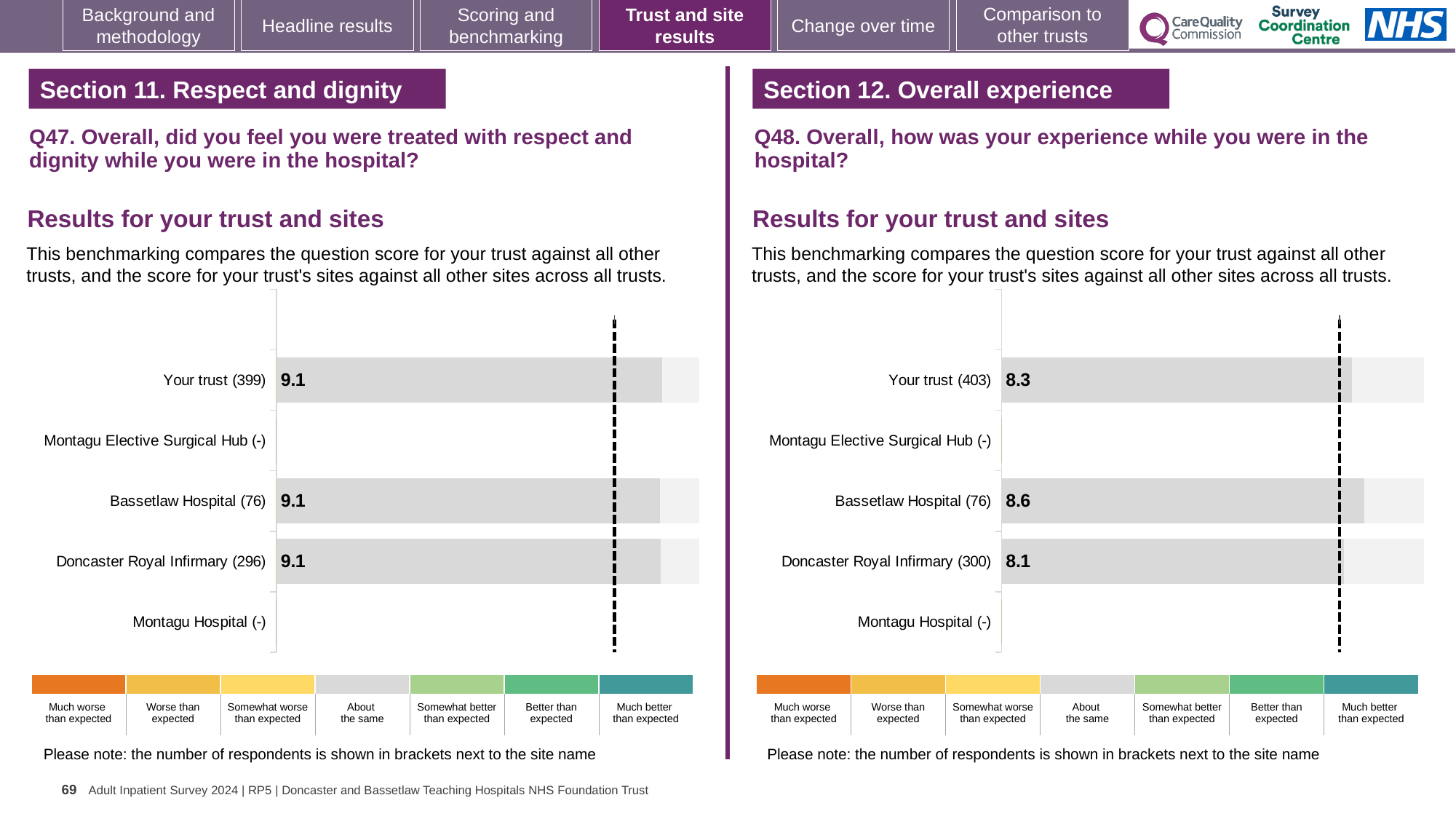
On the Q48 chart (Section 12, right), what is the score for Your trust? 8.3 On the Q48 chart (Section 12, right), which is larger: the score for Your trust or the score for Bassetlaw Hospital? Bassetlaw Hospital On the Q48 chart (Section 12, right), which site has the lowest score among those with a value shown? Doncaster Royal Infirmary On the Q48 chart (Section 12, right), which site has the highest score? Bassetlaw Hospital On the Q47 chart (Section 11, left), what is the score for Doncaster Royal Infirmary? 9.1 On the Q47 chart (Section 11, left), what is the score for Your trust? 9.1 On the Q48 chart (Section 12, right), what is the score for Doncaster Royal Infirmary? 8.1 On the Q48 chart (Section 12, right), what is the difference between the Bassetlaw Hospital score and the Doncaster Royal Infirmary score? 0.5 How many site rows (categories) are listed on the Q47 chart (Section 11, left)? 5 On the Q47 chart (Section 11, left), how many respondents are shown in brackets for Your trust? 399 On the Q48 chart (Section 12, right), what is the score for Bassetlaw Hospital? 8.6 What type of chart is used on the Q48 chart (Section 12, right)? Bar chart